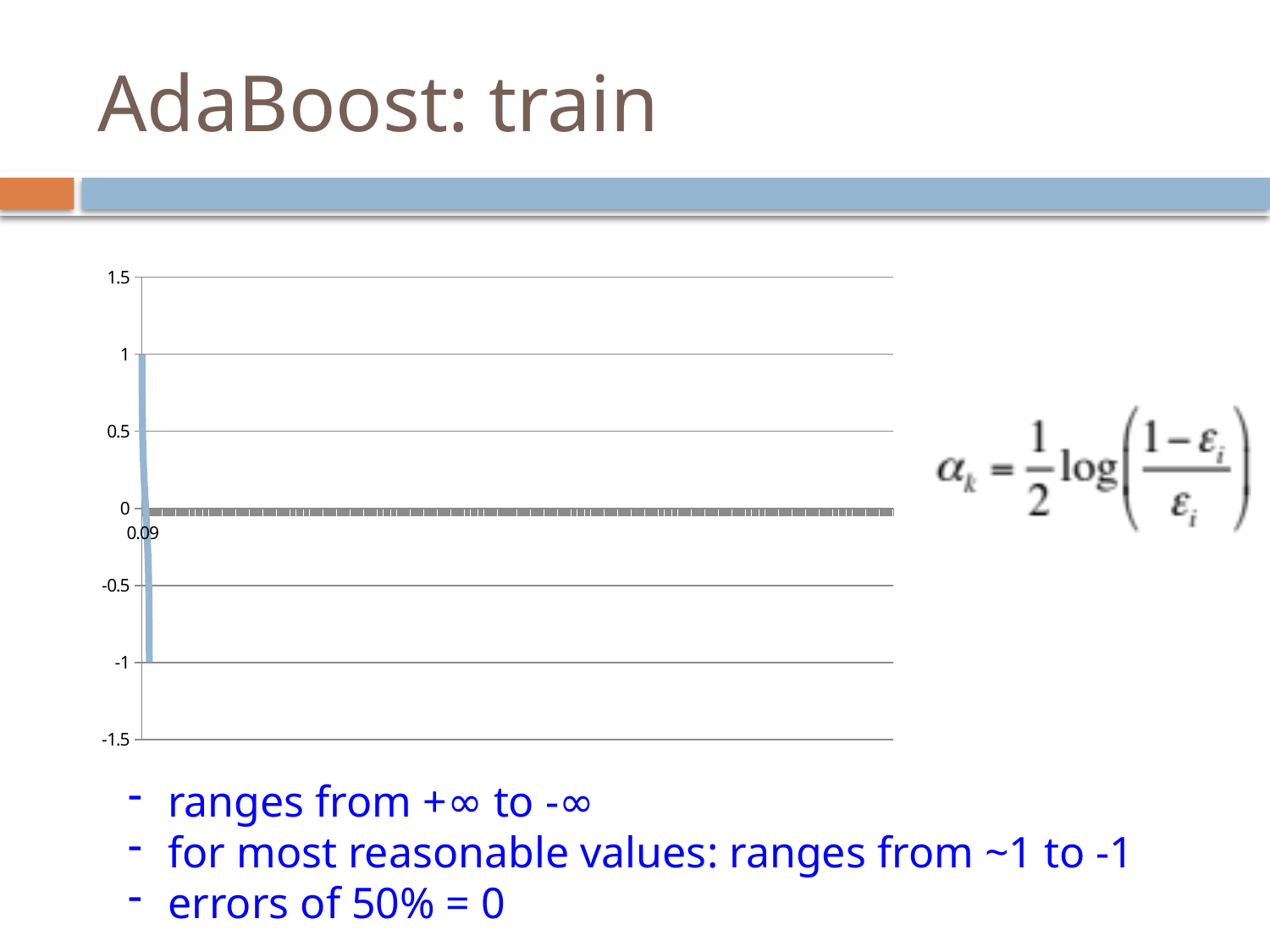
What is the lowest value labelled on the y axis of the chart? -1.5 What is the only x-axis label readable on the chart? 0.09 How many tick labels are shown on the y axis of the chart? 7 Is the lowest point of the plotted line greater or less than -0.5? less Is the highest point of the plotted line greater or less than 0.5? greater What kind of chart is shown on the slide? line chart Do the plotted values rise or fall as you move along the x axis? fall What is the highest value labelled on the y axis of the chart? 1.5